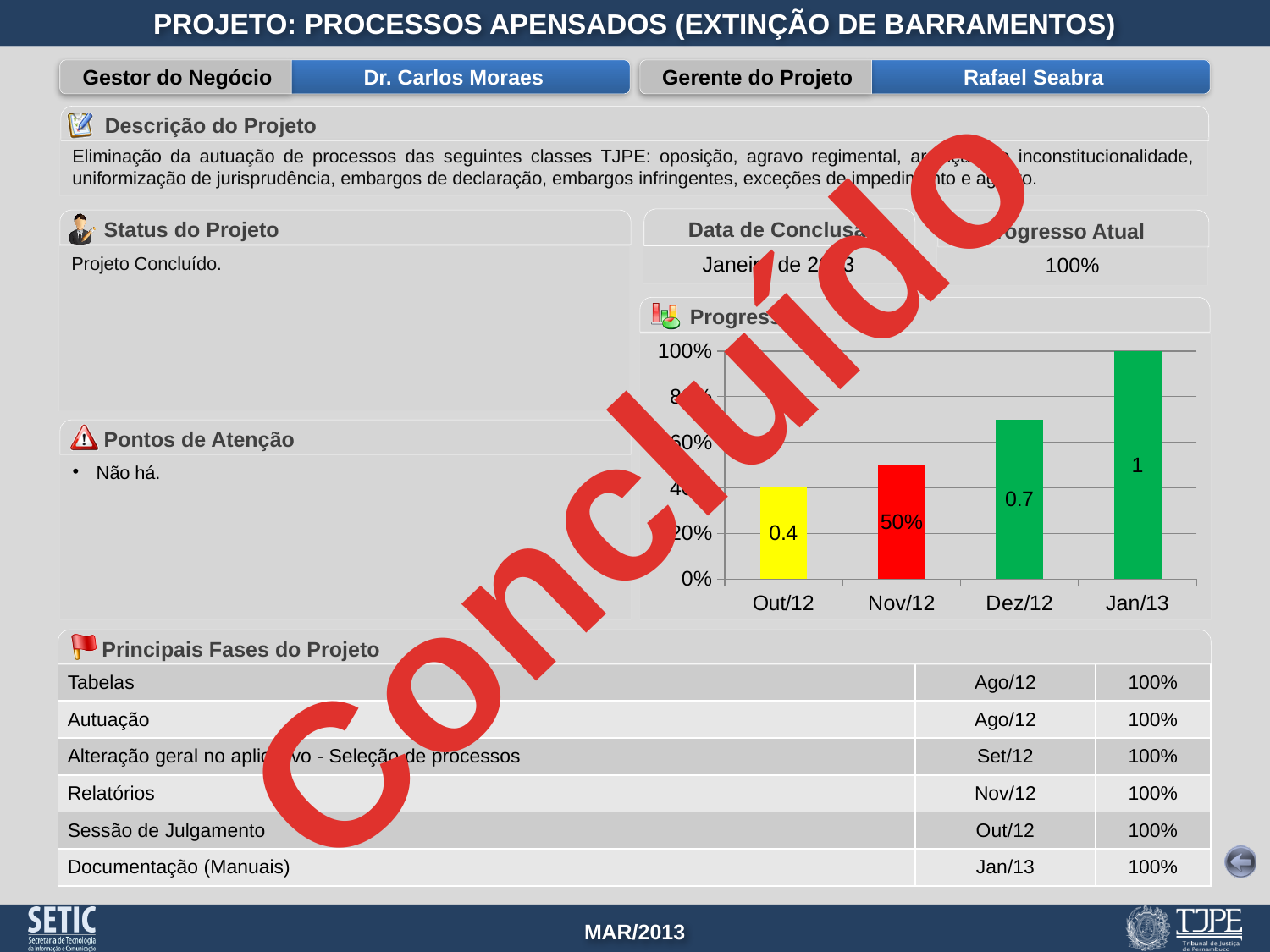
What is the value shown for Jan/13 in the chart? 1 Which category has the highest value in the chart? Jan/13 Do the values in the chart rise or fall from Out/12 to Jan/13? rise What is the value shown for Nov/12 in the chart? 50% What type of chart is shown on the slide? bar chart What is the value shown for Out/12 in the chart? 0.4 What is the value shown for Dez/12 in the chart? 0.7 What is the difference between the values for Dez/12 and Out/12 in the chart? 0.3 Which is larger in the chart, the value for Dez/12 or the value for Nov/12? Dez/12 How many categories are shown on the x axis of the chart? 4 What colour is the bar for Nov/12 in the chart? red Which category has the lowest value in the chart? Out/12